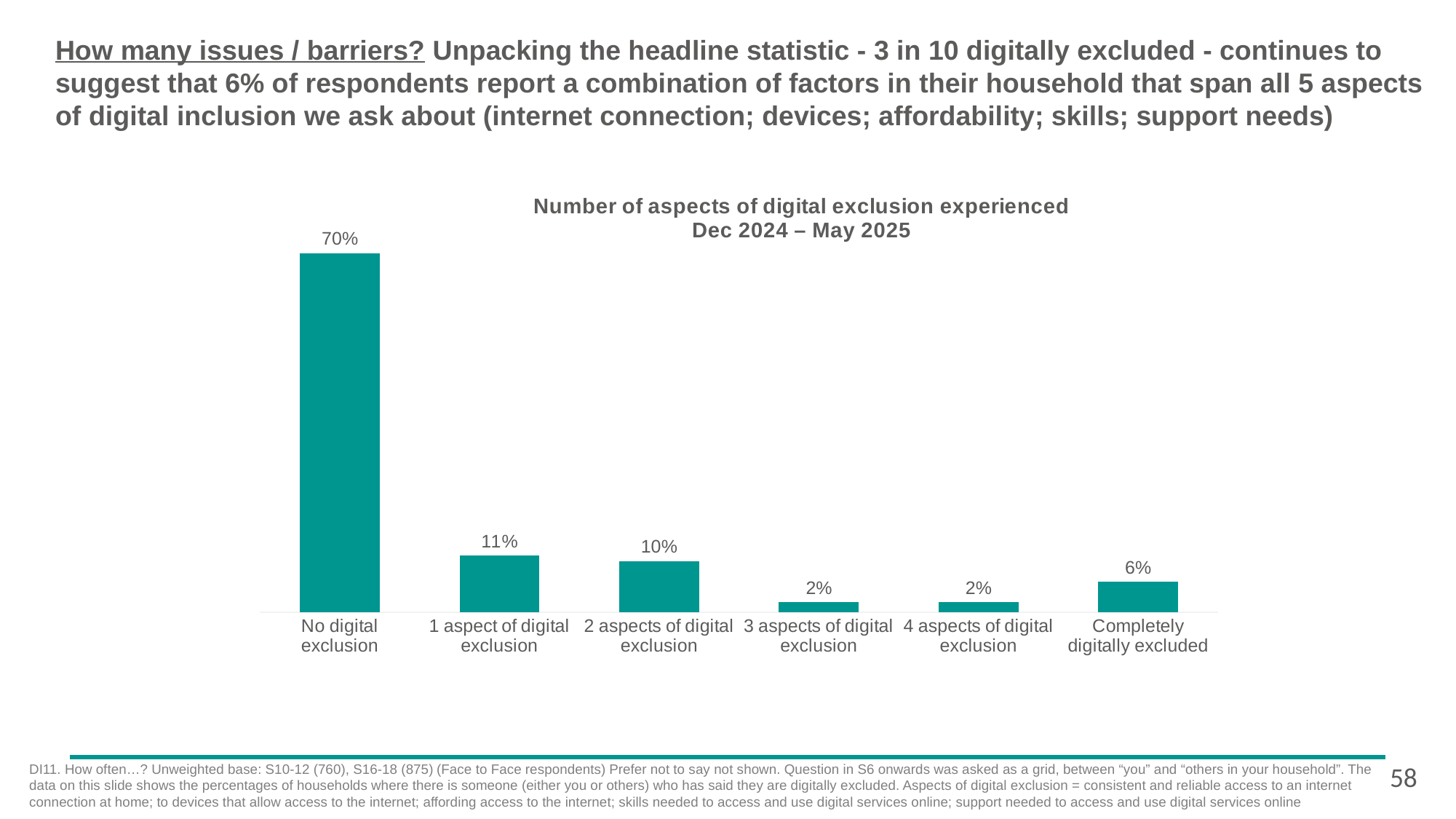
What percentage of respondents report no digital exclusion? 70% What is the difference between 'No digital exclusion' and 'Completely digitally excluded'? 64% What is the title of the chart? Number of aspects of digital exclusion experienced Dec 2024 – May 2025 What is the difference between the values for '1 aspect of digital exclusion' and '2 aspects of digital exclusion'? 1% What is the value for '1 aspect of digital exclusion'? 11% What is the value for '3 aspects of digital exclusion'? 2% What kind of chart is shown on the slide? Bar chart How many categories are shown on the chart? 6 Which category has the highest value? No digital exclusion Which is larger: the value for '2 aspects of digital exclusion' or 'Completely digitally excluded'? 2 aspects of digital exclusion What percentage of respondents are completely digitally excluded? 6% What is the combined value of '3 aspects of digital exclusion' and '4 aspects of digital exclusion'? 4%